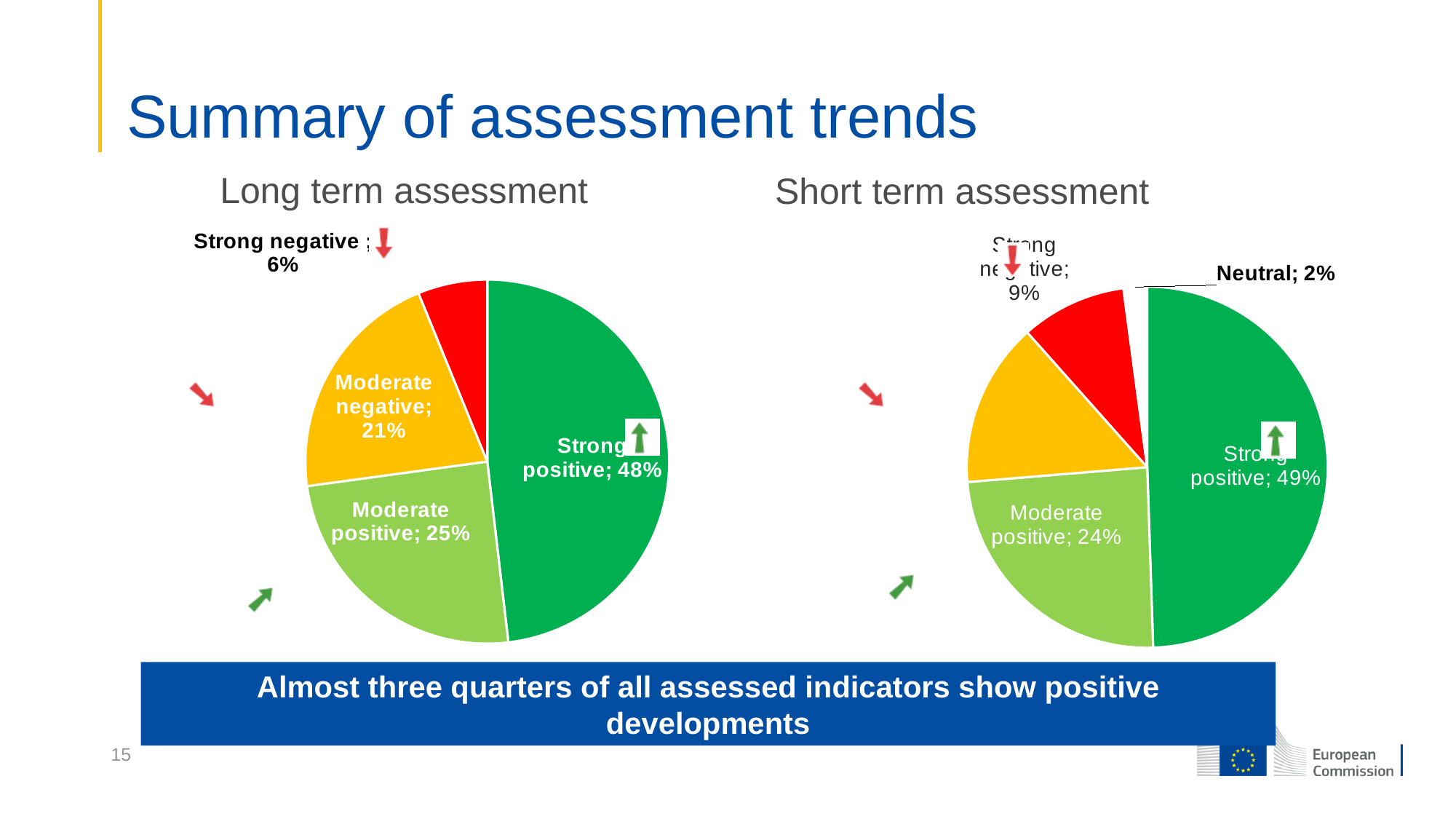
In the Short term assessment chart, what share is labelled Neutral? 2% In the Short term assessment chart, what share is labelled Strong positive? 49% In the Long term assessment chart, what share is labelled Moderate negative? 21% In the Long term assessment chart, what share is labelled Strong positive? 48% In the Long term assessment chart, which category has the largest slice? Strong positive What type of chart is used for the Short term assessment? Pie chart In the Short term assessment chart, which category has the smallest slice? Neutral In the Long term assessment chart, which is larger: Moderate positive or Moderate negative? Moderate positive In the Short term assessment chart, what share is labelled Strong negative? 9% In the Long term assessment chart, which category has the smallest slice? Strong negative How many slices does the Long term assessment pie chart have? 4 In the Long term assessment chart, what is the difference between the Moderate positive and Moderate negative shares? 4%